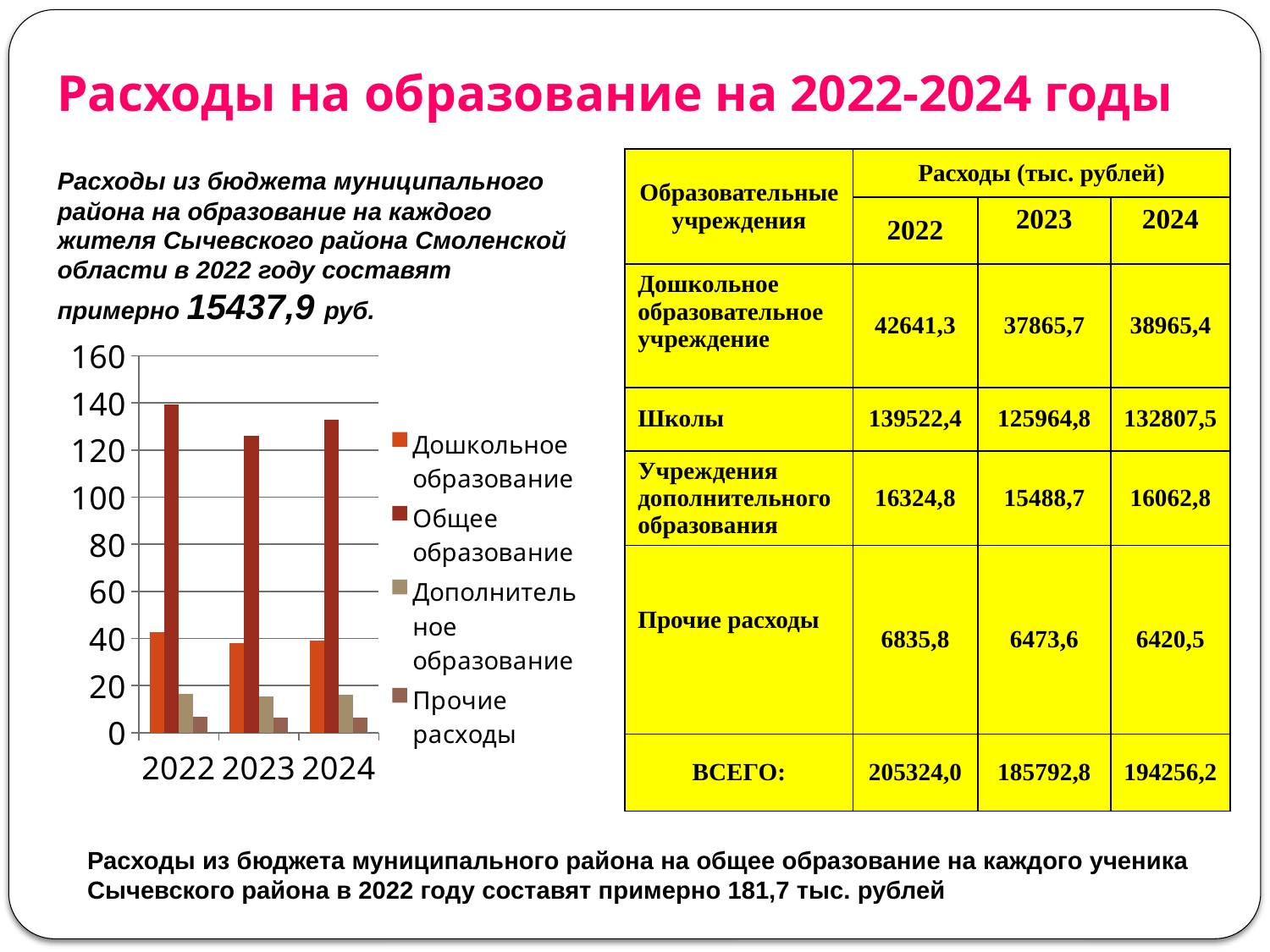
How many years are shown on the x axis of the chart? 3 Which series has the tallest bar in 2022? Общее образование Does the value for Общее образование rise or fall from 2022 to 2023? Falls Is the value for Дошкольное образование in 2022 greater or less than 20? greater What kind of chart is shown on the slide? Bar chart Which series has the shortest bar in 2024? Прочие расходы Which is larger: Общее образование in 2022 or Общее образование in 2023? 2022 Is the value for Общее образование in 2022 greater or less than 120? greater Is the value for Общее образование in 2023 greater or less than 140? less What is the highest tick value shown on the chart's y axis? 160 Which is larger in 2022: Дополнительное образование or Прочие расходы? Дополнительное образование How many series does the chart legend list? 4